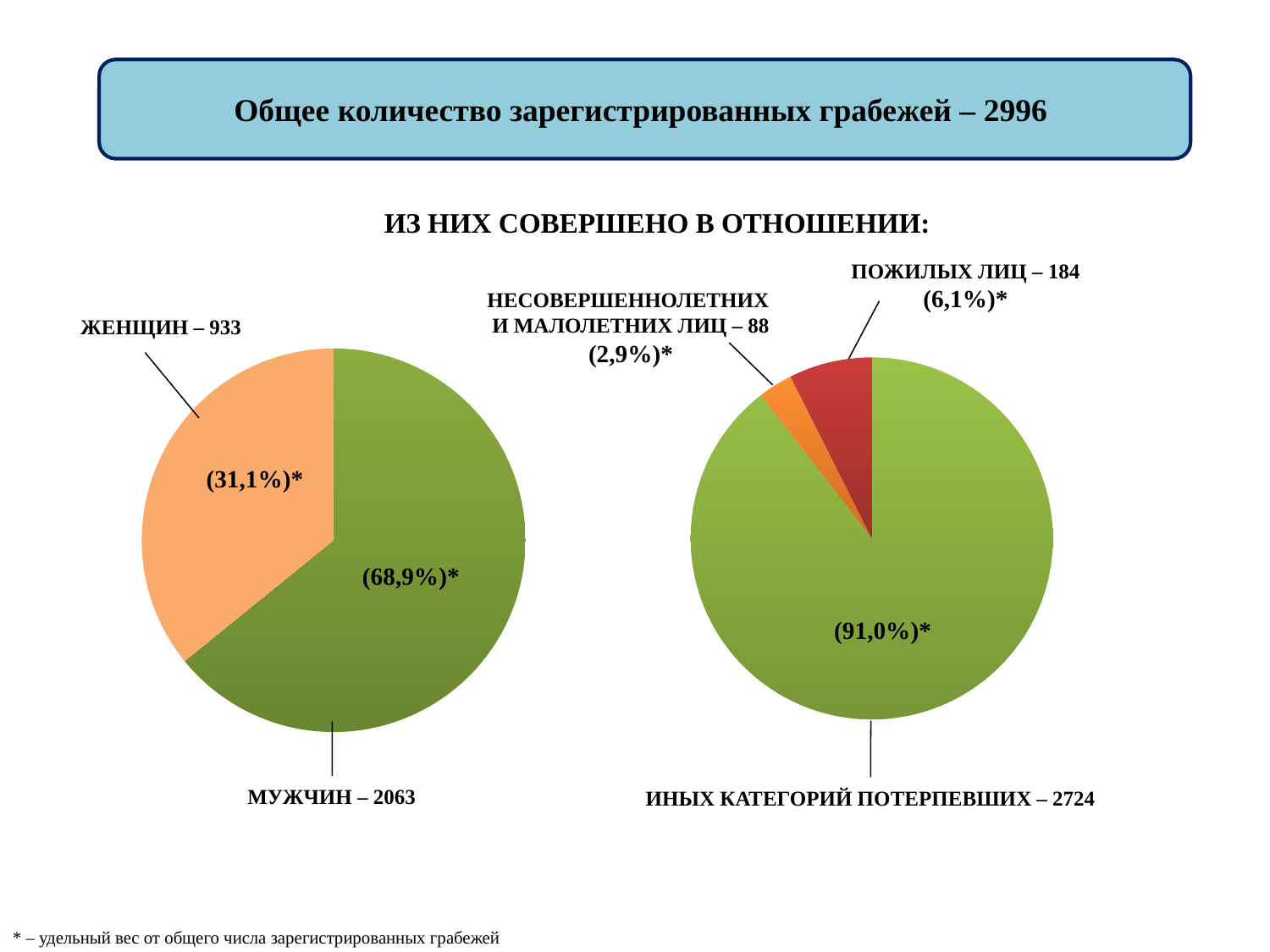
In the right pie chart, what is the value for ПОЖИЛЫХ ЛИЦ? 184 In the right pie chart, which is larger: ПОЖИЛЫХ ЛИЦ or НЕСОВЕРШЕННОЛЕТНИХ И МАЛОЛЕТНИХ ЛИЦ? ПОЖИЛЫХ ЛИЦ What type of chart is the left chart on the slide? pie chart In the right pie chart, what share of the pie does the ИНЫХ КАТЕГОРИЙ ПОТЕРПЕВШИХ slice represent? 91,0% In the left pie chart, what is the value for ЖЕНЩИН? 933 In the right pie chart, what is the value for НЕСОВЕРШЕННОЛЕТНИХ И МАЛОЛЕТНИХ ЛИЦ? 88 In the right pie chart, what is the difference between the values for ПОЖИЛЫХ ЛИЦ and НЕСОВЕРШЕННОЛЕТНИХ И МАЛОЛЕТНИХ ЛИЦ? 96 How many slices does the right pie chart have? 3 In the left pie chart, what is the difference between the values for МУЖЧИН and ЖЕНЩИН? 1130 In the right pie chart, which category has the smallest slice? НЕСОВЕРШЕННОЛЕТНИХ И МАЛОЛЕТНИХ ЛИЦ In the left pie chart, what is the value for МУЖЧИН? 2063 In the left pie chart, what share of the pie does the ЖЕНЩИН slice represent? 31,1%